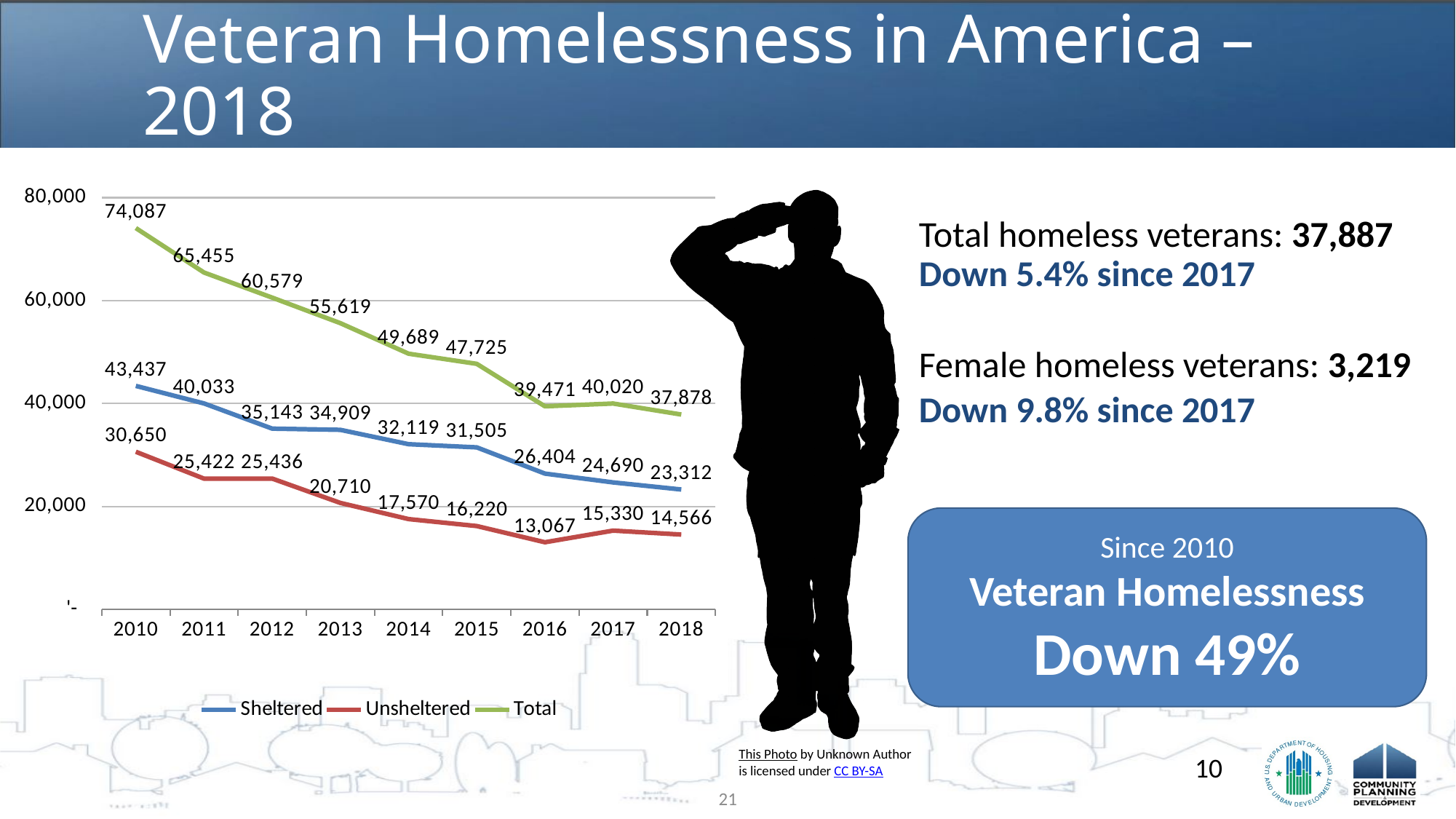
What is the difference between the Total values for 2010 and 2018? 36,209 In which year is the Unsheltered value lowest? 2016 Does the Sheltered series generally rise or fall from 2010 to 2018? Fall What is the Total value for 2010? 74,087 How many series does the chart legend list? 3 In which year is the Total value highest? 2010 What kind of chart is shown on the slide? Line chart How many years are plotted on the x axis? 9 What is the Sheltered value for 2018? 23,312 Which is larger, the Sheltered value for 2017 or the Unsheltered value for 2017? Sheltered (24,690) What is the Unsheltered value for 2016? 13,067 Which colour is used for the Total series in the chart? Green